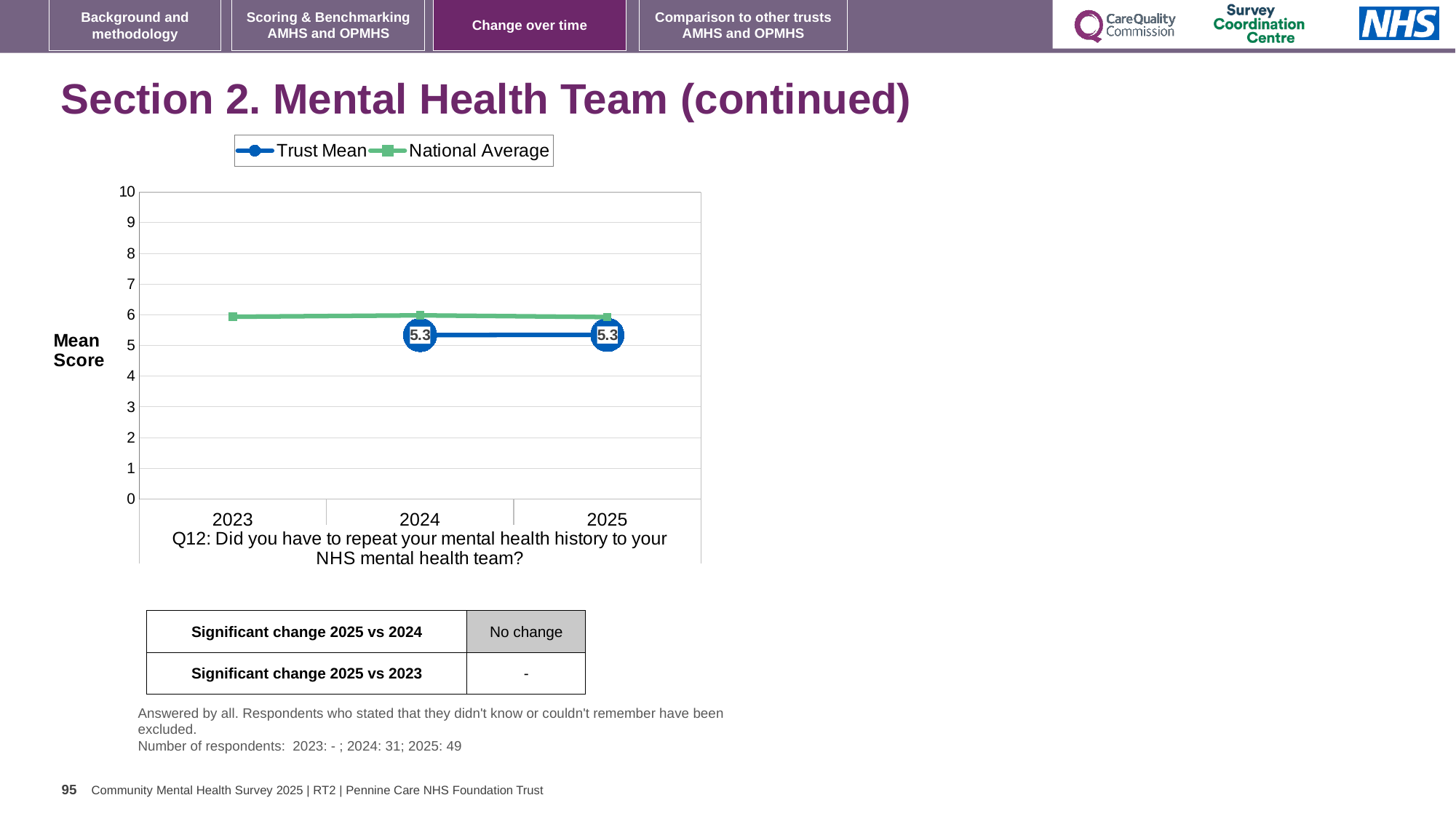
Is the National Average value for 2023 greater or less than 7? less What is the Trust Mean value for 2024? 5.3 What kind of chart is shown on the slide? Line chart What are the two series named in the legend? Trust Mean and National Average What is the difference between the Trust Mean in 2025 and in 2024? 0 Is the National Average value for 2024 greater or less than 5? greater How many years are shown on the x axis? 3 What is the label on the y axis of the chart? Mean Score In 2025, which is larger: the Trust Mean or the National Average? National Average What is the Trust Mean value for 2025? 5.3 Does the Trust Mean rise, fall or stay the same from 2024 to 2025? Stays the same How many series does the legend list? 2